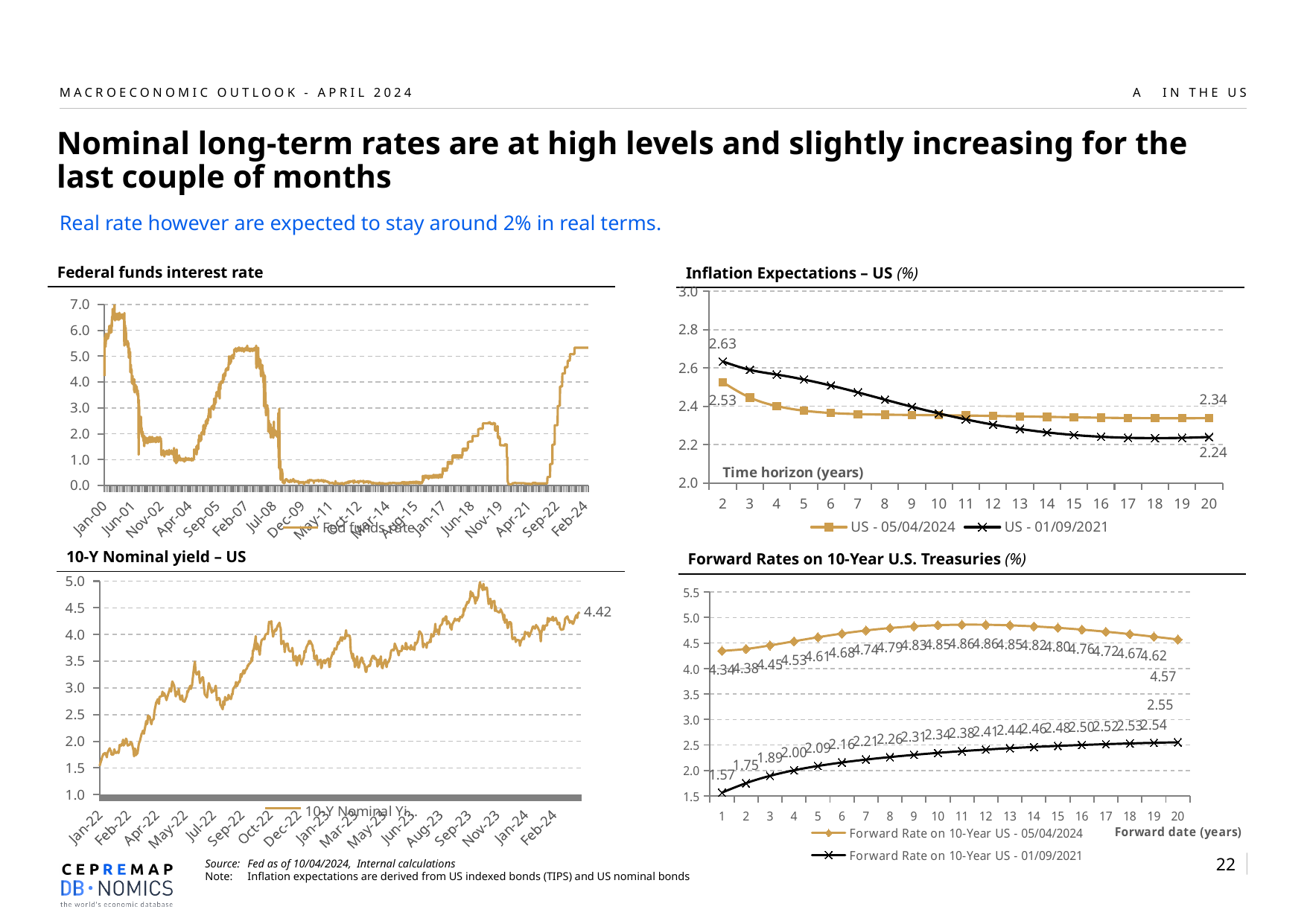
On the Inflation Expectations – US chart, what is the value for US - 01/09/2021 at a 20-year time horizon? 2.24 On the Forward Rates on 10-Year U.S. Treasuries chart, what is the difference between the 05/04/2024 and 01/09/2021 forward rates at a forward date of 1 year? 2.77 On the Inflation Expectations – US chart, what is the value for US - 05/04/2024 at a 2-year time horizon? 2.53 On the Forward Rates on 10-Year U.S. Treasuries chart, what is the Forward Rate on 10-Year US - 05/04/2024 at a forward date of 1 year? 4.34 On the Inflation Expectations – US chart, what is the difference between the US - 01/09/2021 and US - 05/04/2024 values at the 2-year horizon? 0.10 On the Federal funds interest rate chart, is the value at Feb-24 greater or less than 5.0? greater On the Forward Rates on 10-Year U.S. Treasuries chart, what is the Forward Rate on 10-Year US - 01/09/2021 at a forward date of 20 years? 2.55 On the 10-Y Nominal yield – US chart, what is the value labelled at the end of the series? 4.42 On the Inflation Expectations – US chart, does the US - 01/09/2021 series rise or fall as the time horizon increases? fall What kind of chart is the Federal funds interest rate chart? line chart On the Forward Rates on 10-Year U.S. Treasuries chart, how many forward dates are plotted on the x axis? 20 On the Inflation Expectations – US chart, how many series does the legend list? 2